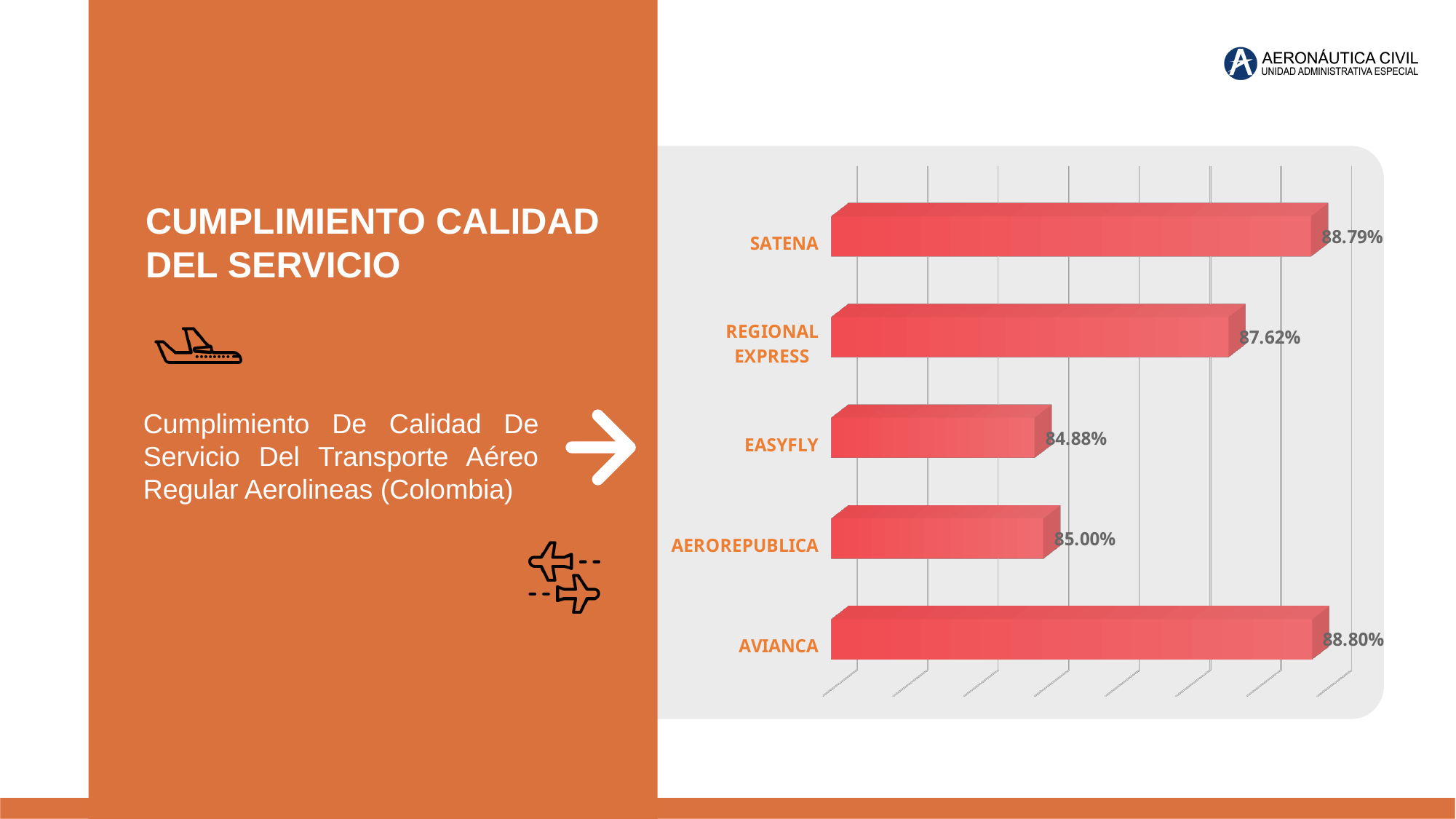
What is the value for SATENA? 88.79% What is the difference between the values for AVIANCA and AEROREPUBLICA? 3.80% What is the value for REGIONAL EXPRESS? 87.62% How many airlines are shown in the chart? 5 What kind of chart is shown on the slide? Bar chart What is the value for EASYFLY? 84.88% What is the difference between the values for SATENA and EASYFLY? 3.91% Which is larger, the value for AEROREPUBLICA or the value for REGIONAL EXPRESS? REGIONAL EXPRESS What is the value for AVIANCA? 88.80% Which airline is listed at the bottom of the chart? AVIANCA Which is larger, the value for SATENA or the value for EASYFLY? SATENA What is the value for AEROREPUBLICA? 85.00%